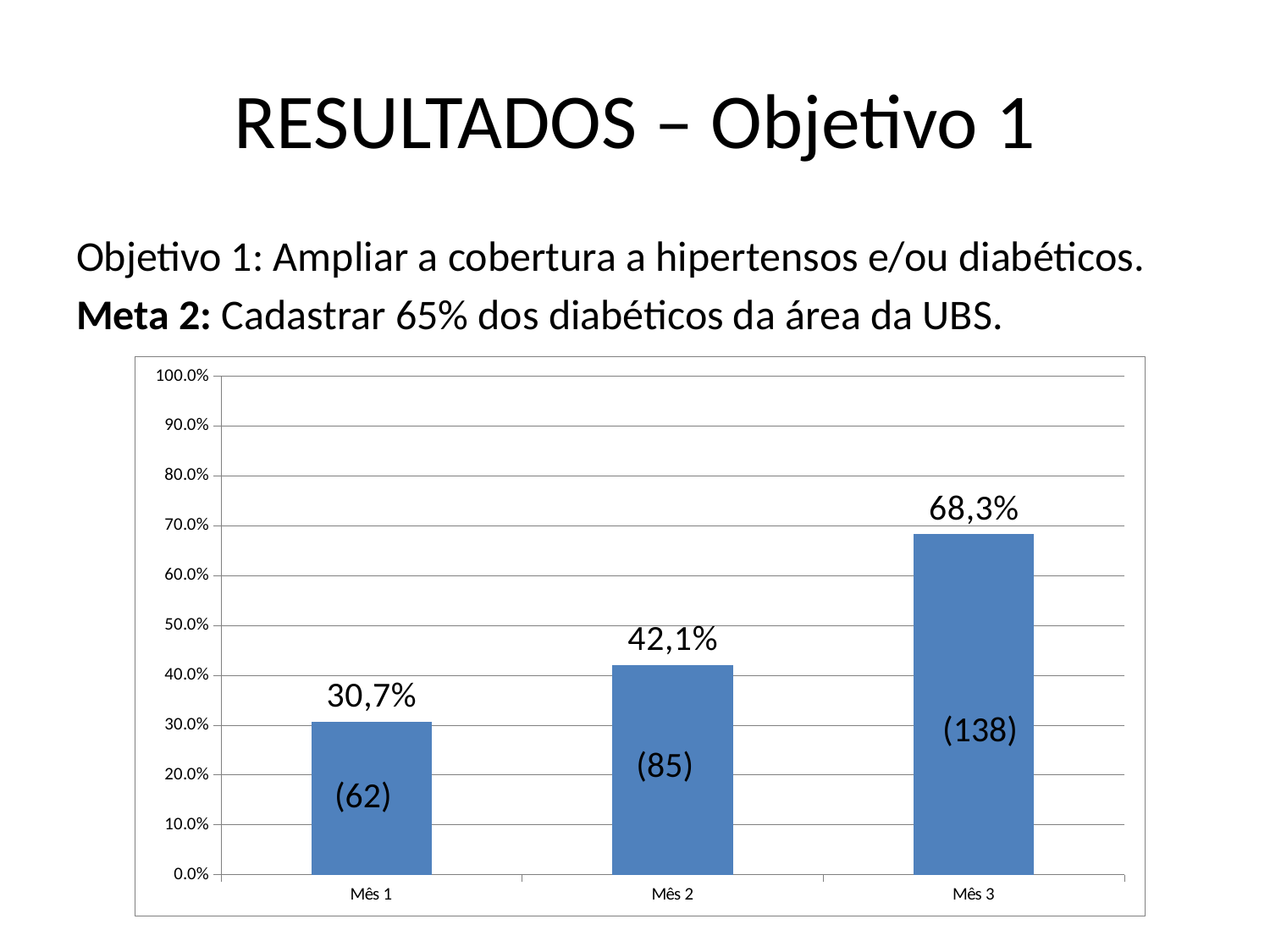
What count is shown in parentheses inside the bar for Mês 3? (138) Which is larger, the value for Mês 2 or the value for Mês 1? Mês 2 What is the difference in percentage points between Mês 3 and Mês 2? 26,2 What is the percentage value shown for Mês 2? 42,1% Which month has the lowest percentage value? Mês 1 What is the percentage value shown for Mês 1? 30,7% What is the percentage value shown for Mês 3? 68,3% Is the value for Mês 3 greater or less than 60.0%? greater Do the values rise or fall from Mês 1 to Mês 3? rise What count is shown in parentheses inside the bar for Mês 1? (62) How many bars are plotted in the chart? 3 Which month has the highest percentage value? Mês 3